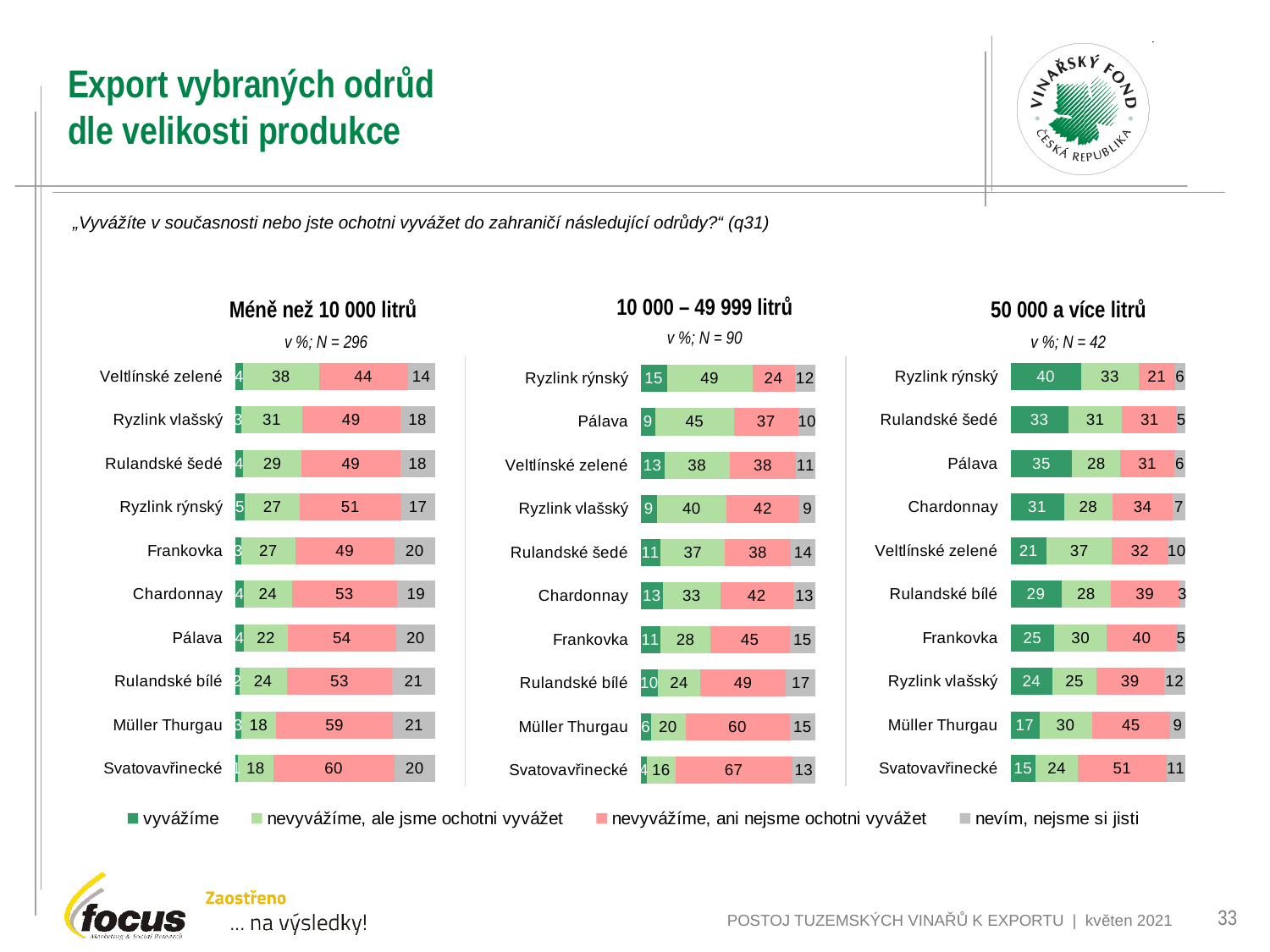
In the chart "50 000 a více litrů", what is the value of "nevyvážíme, ale jsme ochotni vyvážet" for Veltlínské zelené? 37 In the chart "50 000 a více litrů", which is larger: the "vyvážíme" value for Pálava or for Chardonnay? Pálava In the chart "10 000 – 49 999 litrů", which variety has the lowest "vyvážíme" value? Svatovavřinecké In the chart "10 000 – 49 999 litrů", what is the total of the stacked bar for Müller Thurgau? 101 What is the sample size (N) shown for the chart "50 000 a více litrů"? 42 In the chart "Méně než 10 000 litrů", what is the difference between the "nevyvážíme, ani nejsme ochotni vyvážet" values for Müller Thurgau and Veltlínské zelené? 15 In the chart "50 000 a více litrů", which variety has the highest "vyvážíme" value? Ryzlink rýnský How many series does the legend list? 4 How many varieties are shown in the chart "10 000 – 49 999 litrů"? 10 What kind of chart is used on this slide? Stacked bar chart In the chart "Méně než 10 000 litrů", what is the value of "nevyvážíme, ani nejsme ochotni vyvážet" for Svatovavřinecké? 60 In the chart "10 000 – 49 999 litrů", what is the value of "vyvážíme" for Ryzlink rýnský? 15